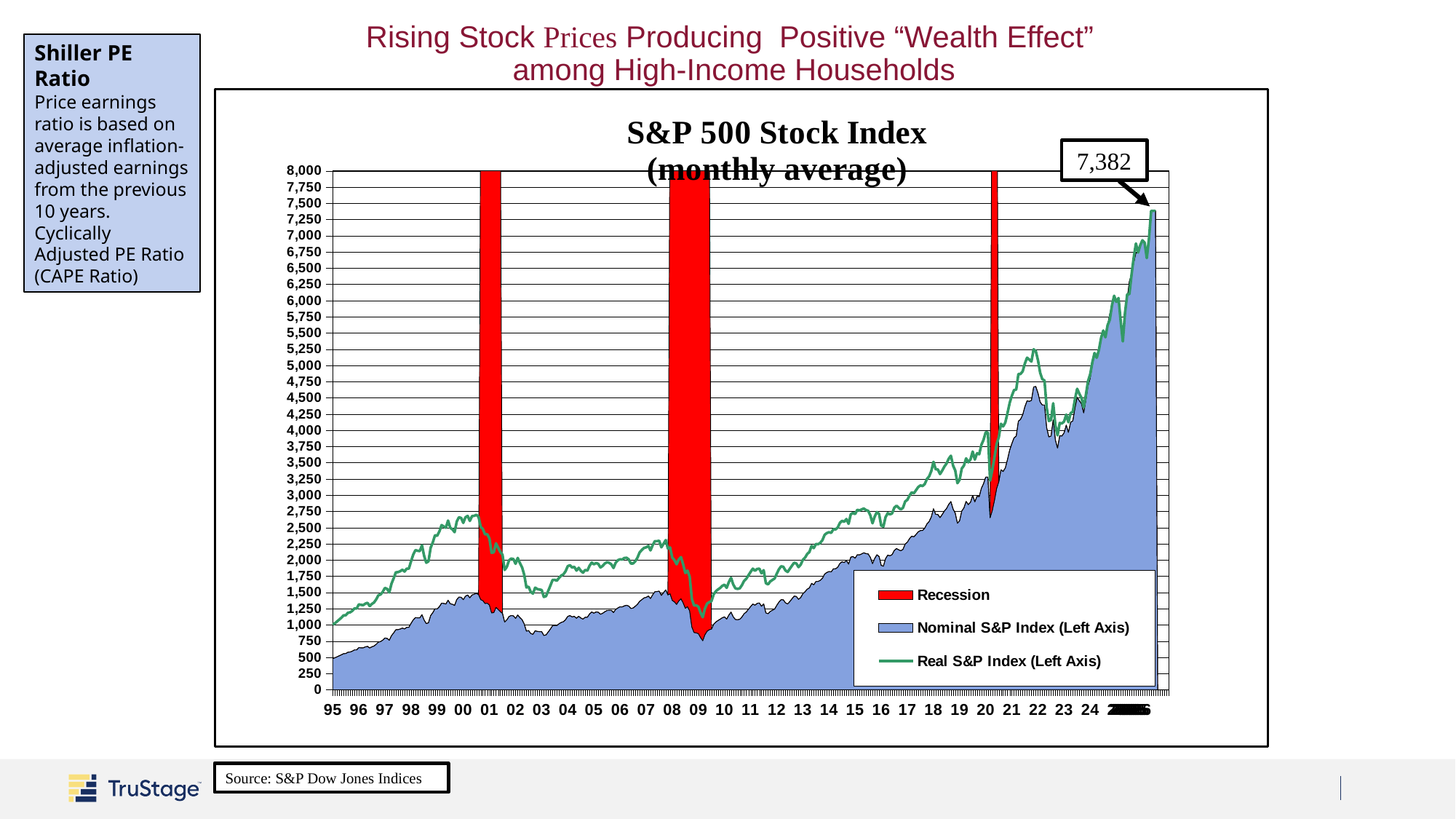
What is the title of the chart? S&P 500 Stock Index (monthly average) Which is larger in 2000, the Real S&P Index or the Nominal S&P Index? Real S&P Index Does the Nominal S&P Index generally rise or fall from 95 to 26? rise What is the value shown by the data label at the end of the Nominal S&P Index series? 7,382 How many series does the legend list? 3 Is the Real S&P Index at its 2000 peak greater or less than 2,500? greater How many recession periods are shaded on the chart? 3 Is the Real S&P Index at its 2022 peak greater or less than 5,000? greater Is the Nominal S&P Index at its 2009 low greater or less than 1,000? less What kind of chart is this? area and line chart What colour is used for the Recession series in the legend? red